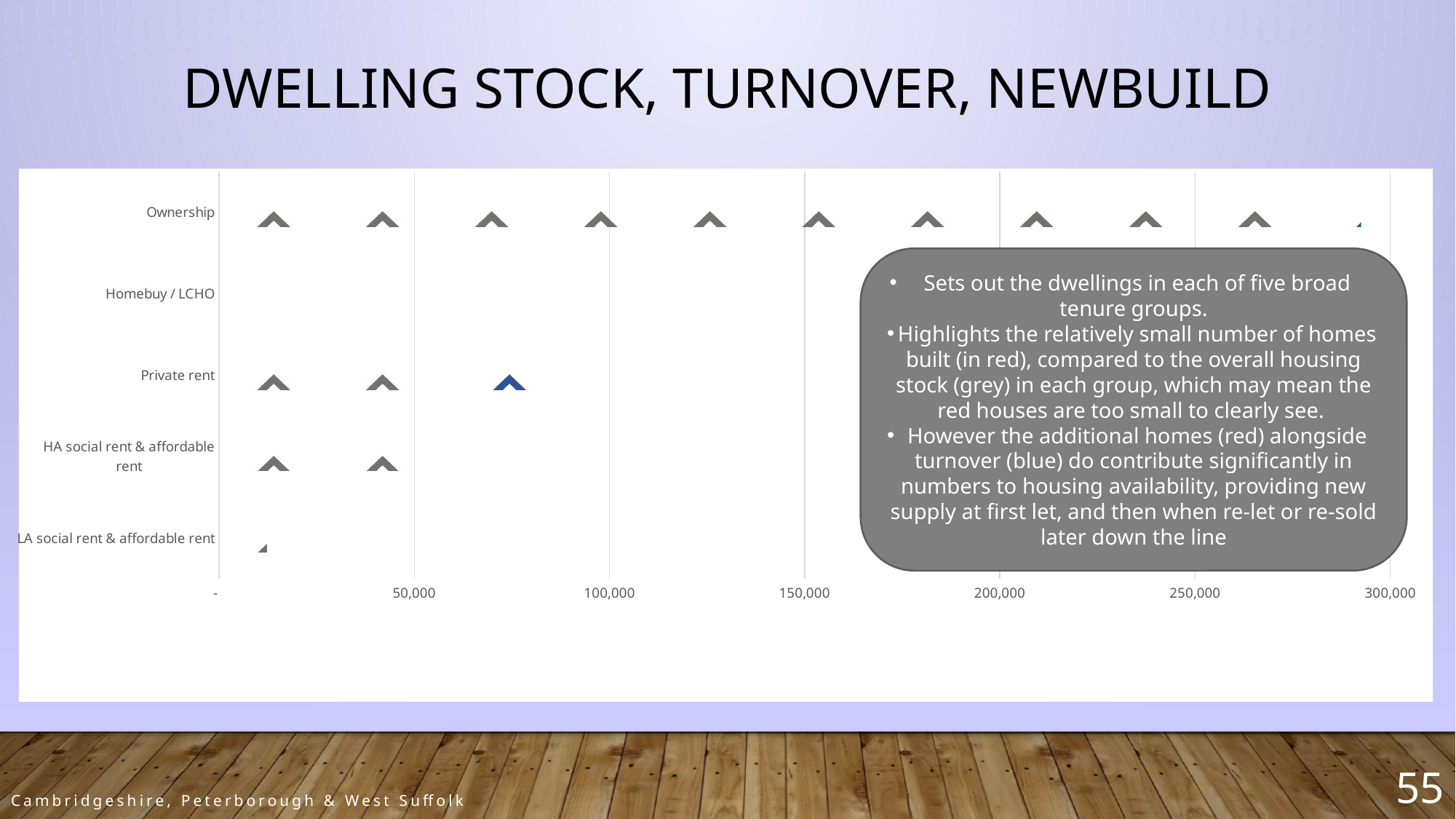
Which is larger, the value for Ownership or the value for Private rent? Ownership Is the value for HA social rent & affordable rent greater or less than 100,000? less How many tenure categories are listed on the vertical axis of the chart? 5 Which tenure category has the highest value in the chart? Ownership What kind of chart is shown on the slide? bar chart What is the highest value labelled on the horizontal axis of the chart? 300,000 Is the value for Private rent greater or less than 50,000? greater Which is larger, the value for Private rent or the value for HA social rent & affordable rent? Private rent Is the value for Private rent greater or less than 100,000? less What is the title of the slide containing the chart? Dwelling Stock, Turnover, Newbuild